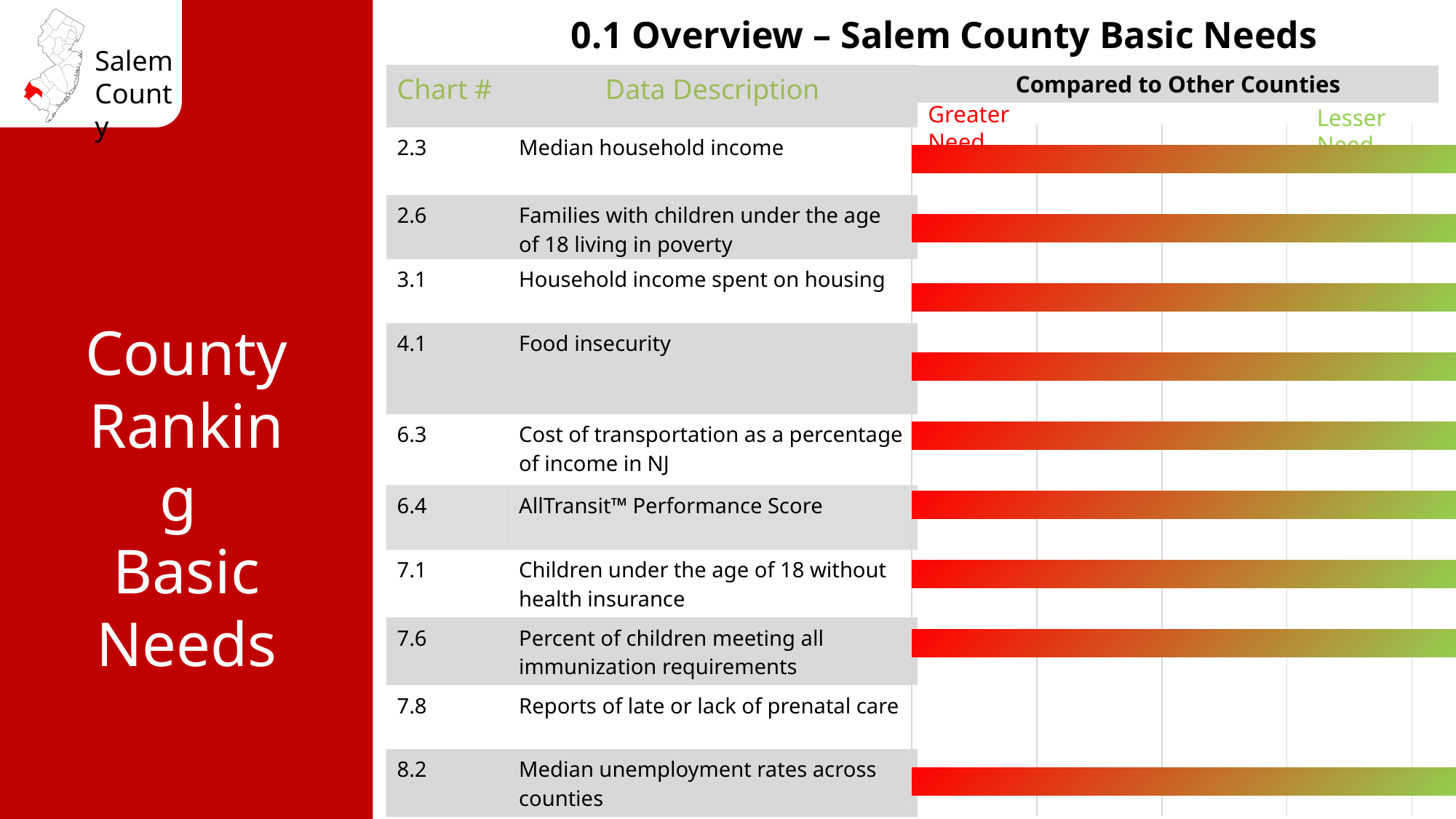
Which data description is listed for chart number 8.2? Median unemployment rates across counties What kind of chart is used to compare Salem County to other counties on this slide? bar chart What label appears at the left end of the bar scale, and what label appears at the right end? Greater Need (left), Lesser Need (right) Which chart number's row has no bar drawn in the 'Compared to Other Counties' column? 7.8 What is the title of the slide containing the chart? 0.1 Overview – Salem County Basic Needs How many data descriptions (rows) are listed in the table on this slide? 10 Which chart number corresponds to the data description 'Food insecurity'? 4.1